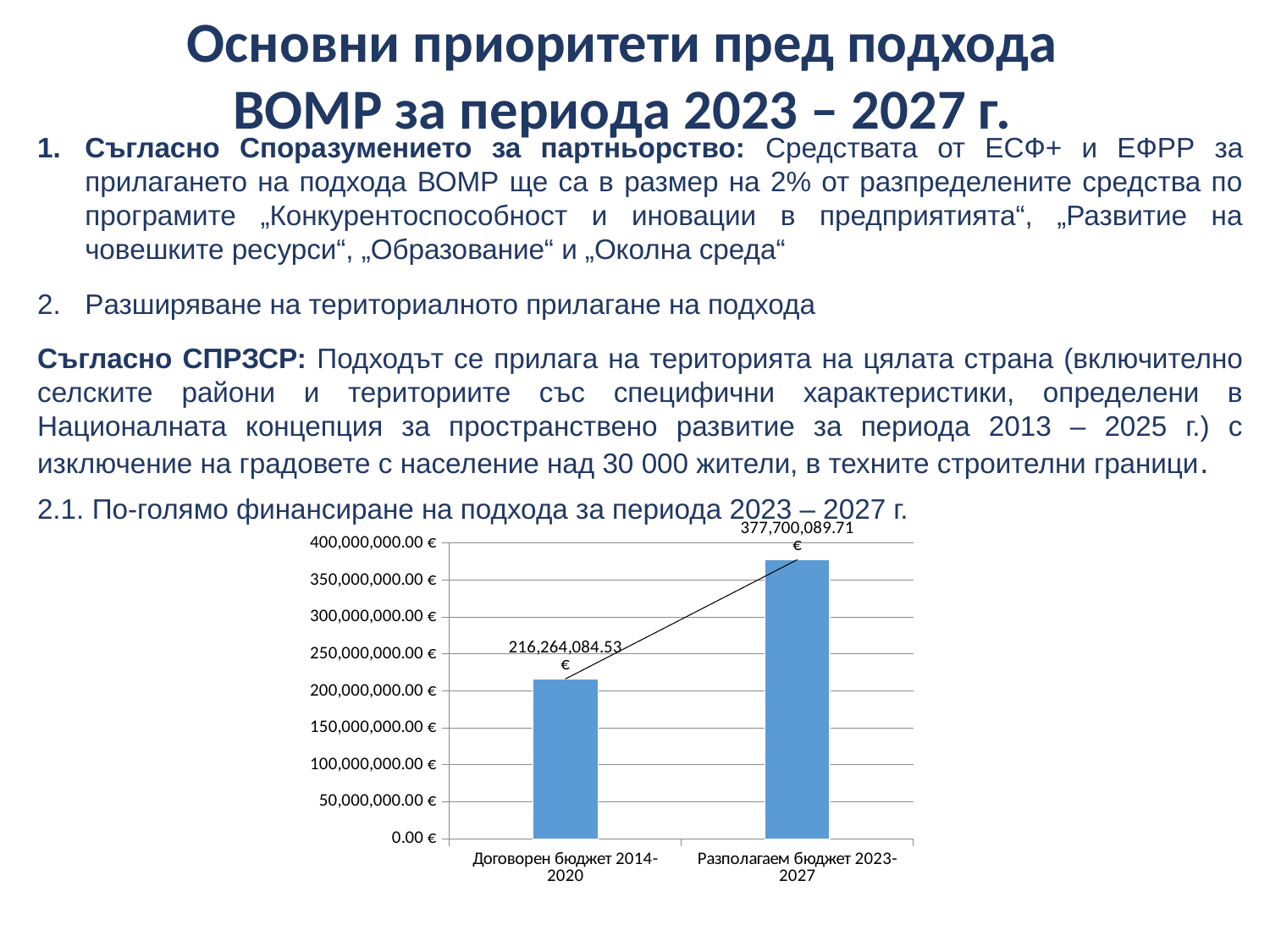
What is the highest value shown on the vertical axis of the chart? 400,000,000.00 € How many categories are shown on the chart? 2 Is the value for Разполагаем бюджет 2023-2027 greater or less than 350,000,000.00 €? greater Which category has the lowest value? Договорен бюджет 2014-2020 Do the values rise or fall from the 2014-2020 category to the 2023-2027 category? rise What is the value for Договорен бюджет 2014-2020? 216,264,084.53 € Which is larger: the value for Договорен бюджет 2014-2020 or the value for Разполагаем бюджет 2023-2027? Разполагаем бюджет 2023-2027 Is the value for Договорен бюджет 2014-2020 greater or less than 200,000,000.00 €? greater What kind of chart is shown on the slide? bar chart Which category has the highest value? Разполагаем бюджет 2023-2027 What is the value for Разполагаем бюджет 2023-2027? 377,700,089.71 € What is the difference between the value for Разполагаем бюджет 2023-2027 and the value for Договорен бюджет 2014-2020? 161,436,005.18 €